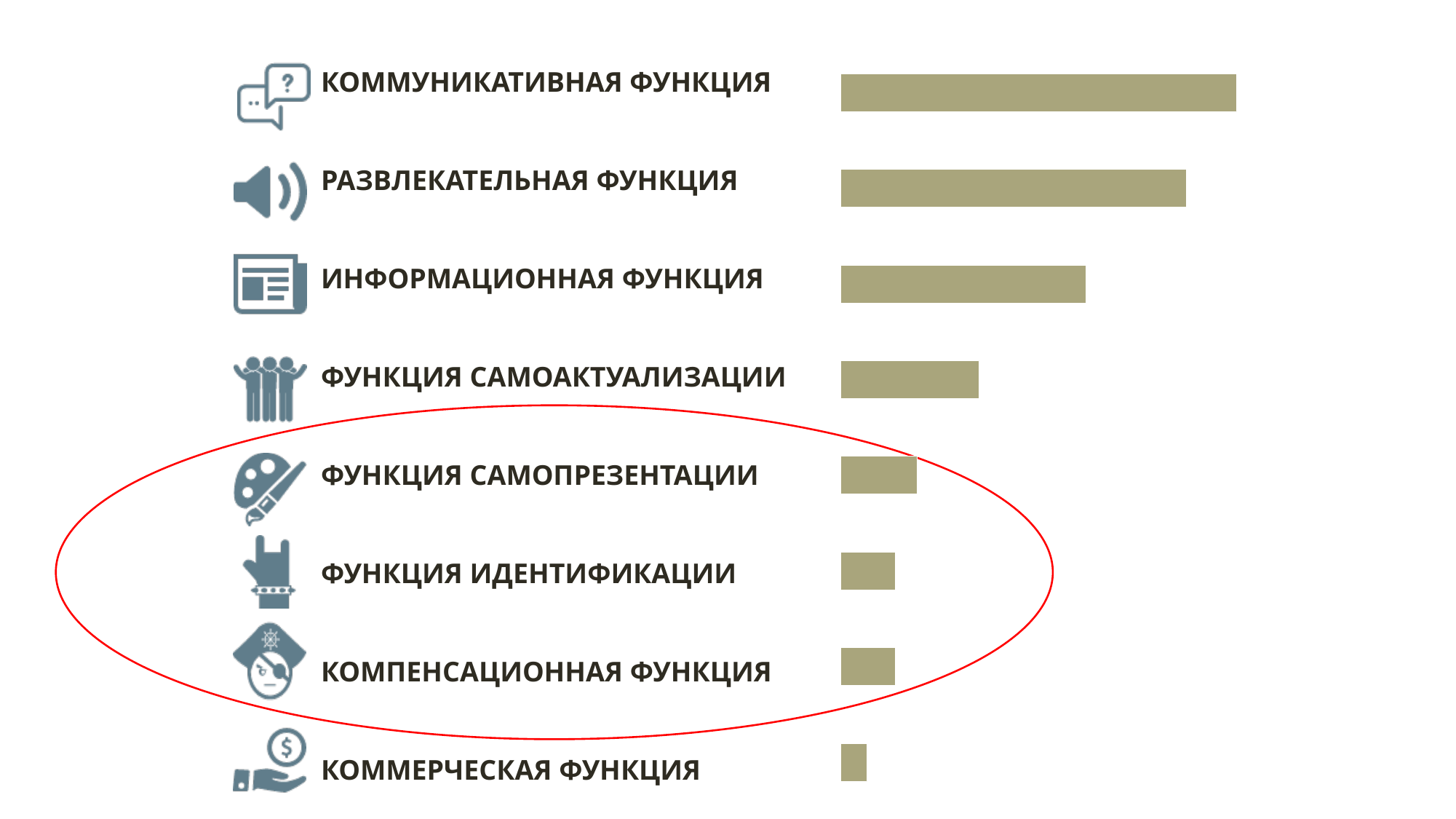
What kind of chart is shown on the slide? bar chart Which bar is longer: ИНФОРМАЦИОННАЯ ФУНКЦИЯ or ФУНКЦИЯ САМОПРЕЗЕНТАЦИИ? ИНФОРМАЦИОННАЯ ФУНКЦИЯ Which bar is longer: ФУНКЦИЯ САМОАКТУАЛИЗАЦИИ or КОМПЕНСАЦИОННАЯ ФУНКЦИЯ? ФУНКЦИЯ САМОАКТУАЛИЗАЦИИ Which bar is longer: РАЗВЛЕКАТЕЛЬНАЯ ФУНКЦИЯ or ИНФОРМАЦИОННАЯ ФУНКЦИЯ? РАЗВЛЕКАТЕЛЬНАЯ ФУНКЦИЯ Do the bars get longer or shorter going from the top of the chart to the bottom? shorter Which function is listed second from the top in the chart? РАЗВЛЕКАТЕЛЬНАЯ ФУНКЦИЯ How many functions are enclosed by the red ellipse on the slide? 3 How many categories (functions) does the chart show? 8 Which function has the longest bar? КОММУНИКАТИВНАЯ ФУНКЦИЯ Which function has the shortest bar? КОММЕРЧЕСКАЯ ФУНКЦИЯ